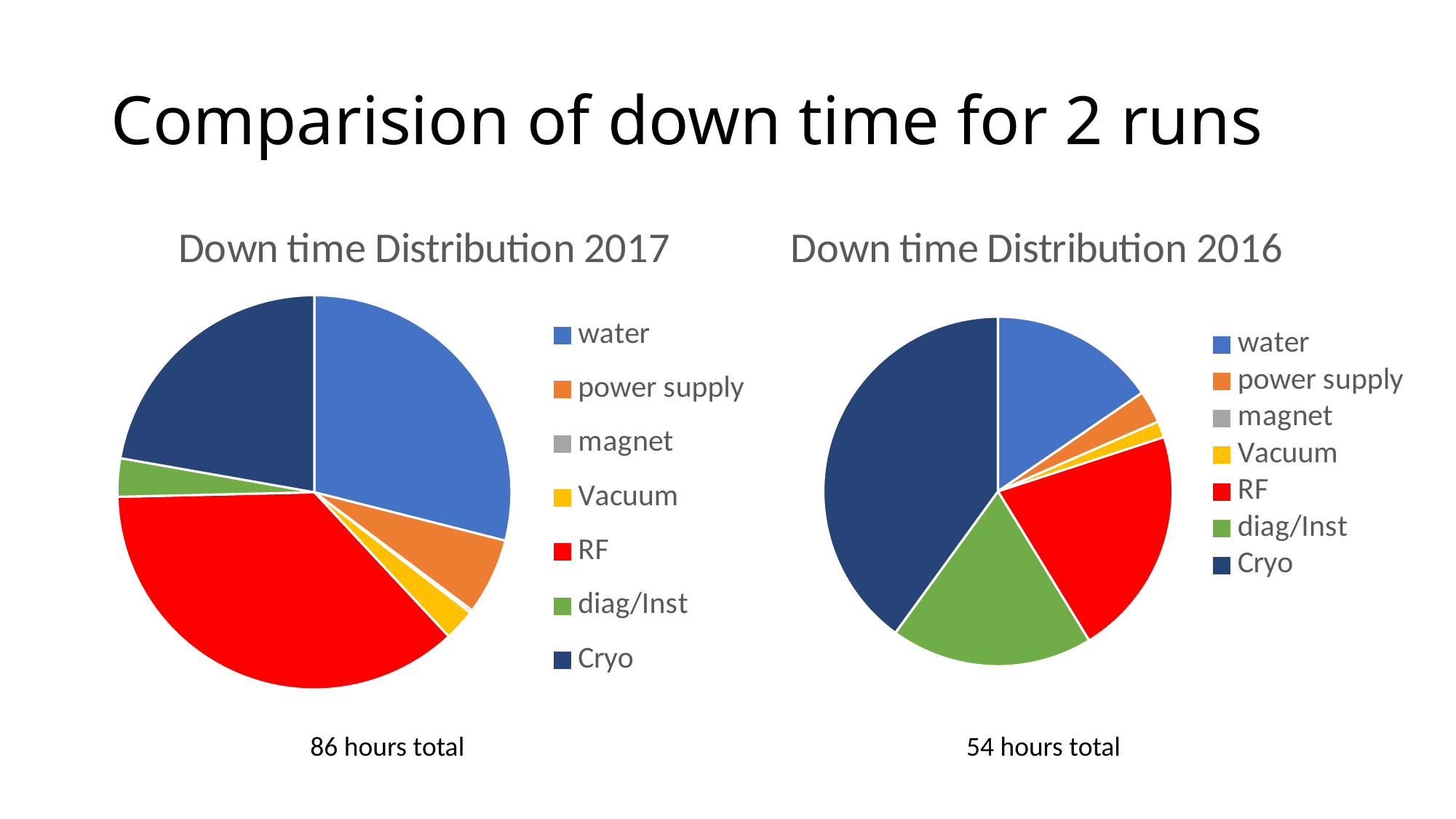
What total number of down time hours is stated below the Down time Distribution 2017 chart? 86 hours total In the Down time Distribution 2016 chart, which slice is larger, Cryo or water? Cryo What total number of down time hours is stated below the Down time Distribution 2016 chart? 54 hours total What kind of chart is the Down time Distribution 2017 chart? pie chart What colour represents RF in both pie charts? red In the Down time Distribution 2017 chart, which category has the largest slice? RF In the Down time Distribution 2017 chart, which slice is larger, Cryo or diag/Inst? Cryo What is the title of the pie chart on the right of the slide? Down time Distribution 2016 In the Down time Distribution 2016 chart, which category has the largest slice? Cryo How many categories does the legend of the Down time Distribution 2016 chart list? 7 In the Down time Distribution 2017 chart, which slice is larger, water or power supply? water